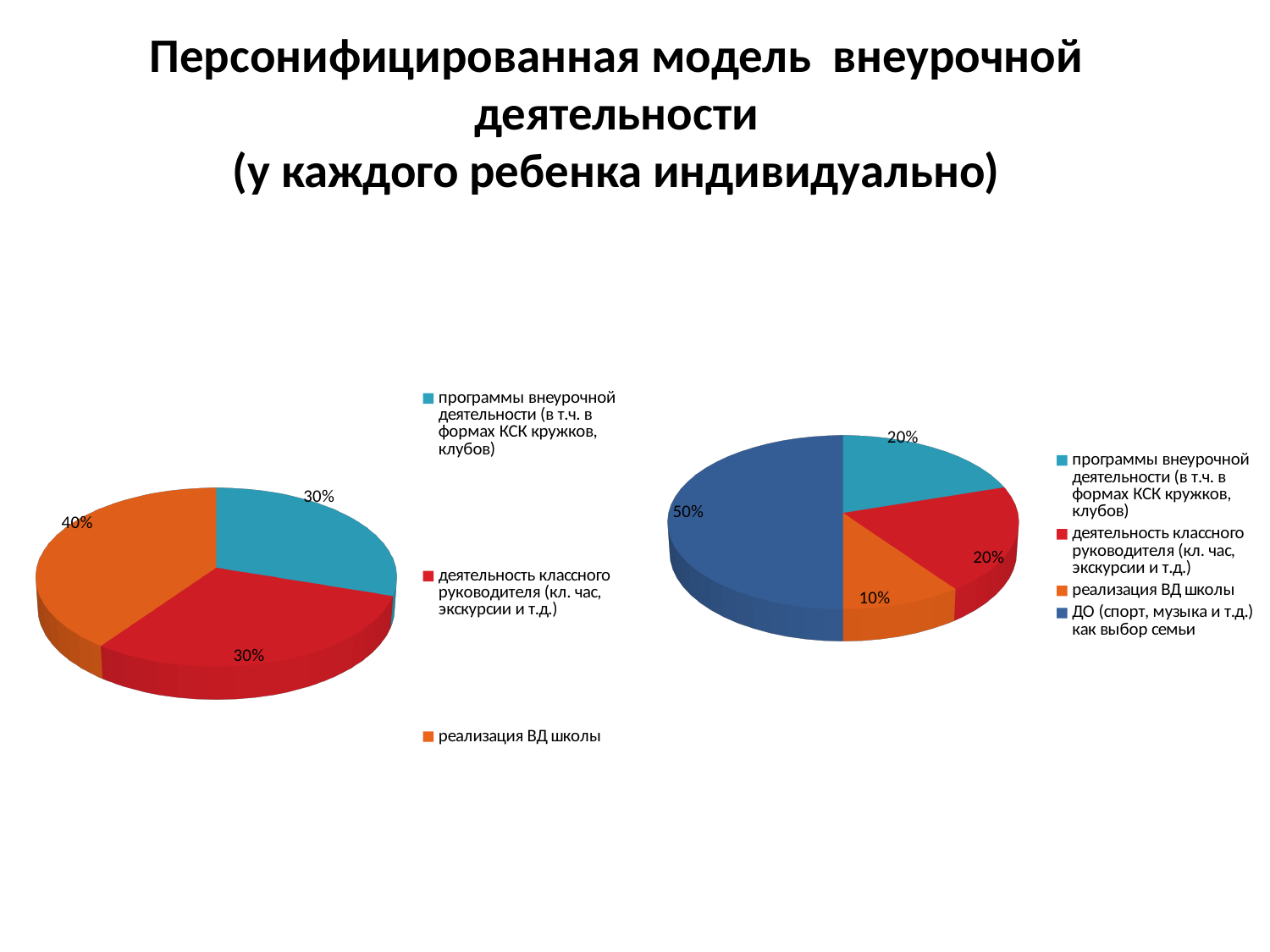
In the left pie chart, what share is shown for "реализация ВД школы"? 40% How many entries does the legend of the right pie chart list? 4 In the right pie chart, what share is shown for "реализация ВД школы"? 10% In the right pie chart, what share is shown for "деятельность классного руководителя (кл. час, экскурсии и т.д.)"? 20% In the right pie chart, which category has the smallest slice? реализация ВД школы In the right pie chart, what is the difference between the share for "ДО (спорт, музыка и т.д.) как выбор семьи" and the share for "реализация ВД школы"? 40% What type of chart is the chart on the right of the slide? Pie chart In the left pie chart, what share is shown for "программы внеурочной деятельности (в т.ч. в формах КСК кружков, клубов)"? 30% In the right pie chart, what share is shown for "ДО (спорт, музыка и т.д.) как выбор семьи"? 50% In the left pie chart, which category has the largest slice? реализация ВД школы How many slices does the left pie chart have? 3 In the right pie chart, which category has the largest slice? ДО (спорт, музыка и т.д.) как выбор семьи